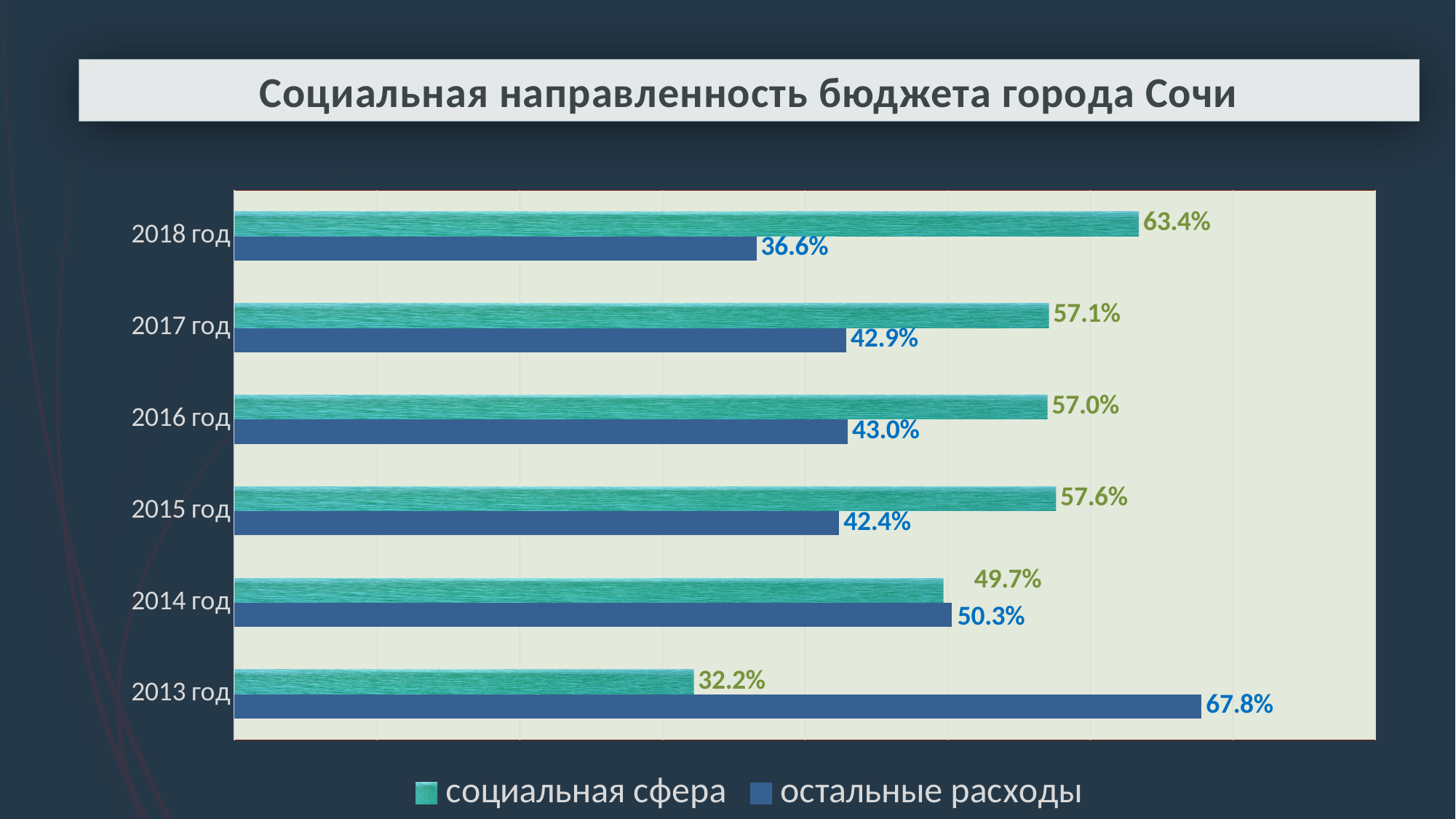
What is the difference between the социальная сфера values for 2018 год and 2013 год? 31.2% What is the value for остальные расходы in 2016 год? 43.0% What is the value for остальные расходы in 2013 год? 67.8% What kind of chart is shown on the slide? Bar chart How many years are shown on the chart? 6 Which is larger in 2014 год: социальная сфера or остальные расходы? остальные расходы What is the difference between социальная сфера and остальные расходы in 2018 год? 26.8% Which year has the highest value for социальная сфера? 2018 год What is the title of the chart? Социальная направленность бюджета города Сочи What is the value for социальная сфера in 2018 год? 63.4% How many series does the legend list? 2 Which year has the lowest value for социальная сфера? 2013 год